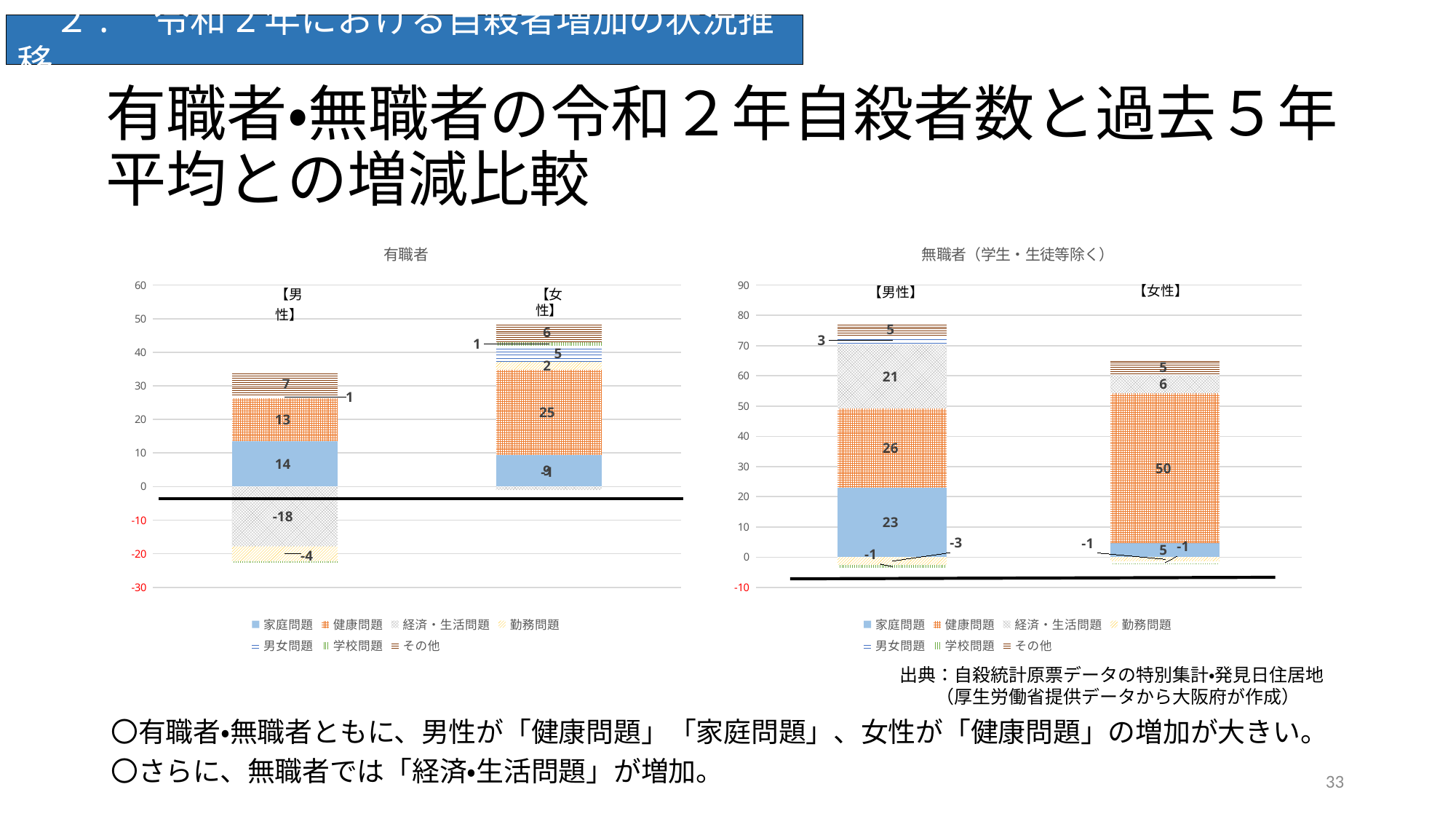
In the right chart titled 無職者（学生・生徒等除く）, what is the value of 経済・生活問題 for 男性? 21 In the left chart titled 有職者, what is the value of 健康問題 for 男性? 13 In the left chart titled 有職者, what is the value of 経済・生活問題 for 男性? -18 What kind of chart is the right chart titled 無職者（学生・生徒等除く）? Stacked bar chart In the right chart titled 無職者（学生・生徒等除く）, which has the larger 健康問題 value, 男性 or 女性? 女性 In the right chart titled 無職者（学生・生徒等除く）, what is the value of 健康問題 for 女性? 50 In the left chart titled 有職者, what is the value of その他 for 男性? 7 How many series does the legend of the left chart titled 有職者 list? 7 In the right chart titled 無職者（学生・生徒等除く）, how much larger is the 健康問題 value for 女性 than for 男性? 24 In the left chart titled 有職者, what is the value of 家庭問題 for 男性? 14 In the right chart titled 無職者（学生・生徒等除く）, what is the value of 家庭問題 for 男性? 23 In the left chart titled 有職者, what is the value of 健康問題 for 女性? 25